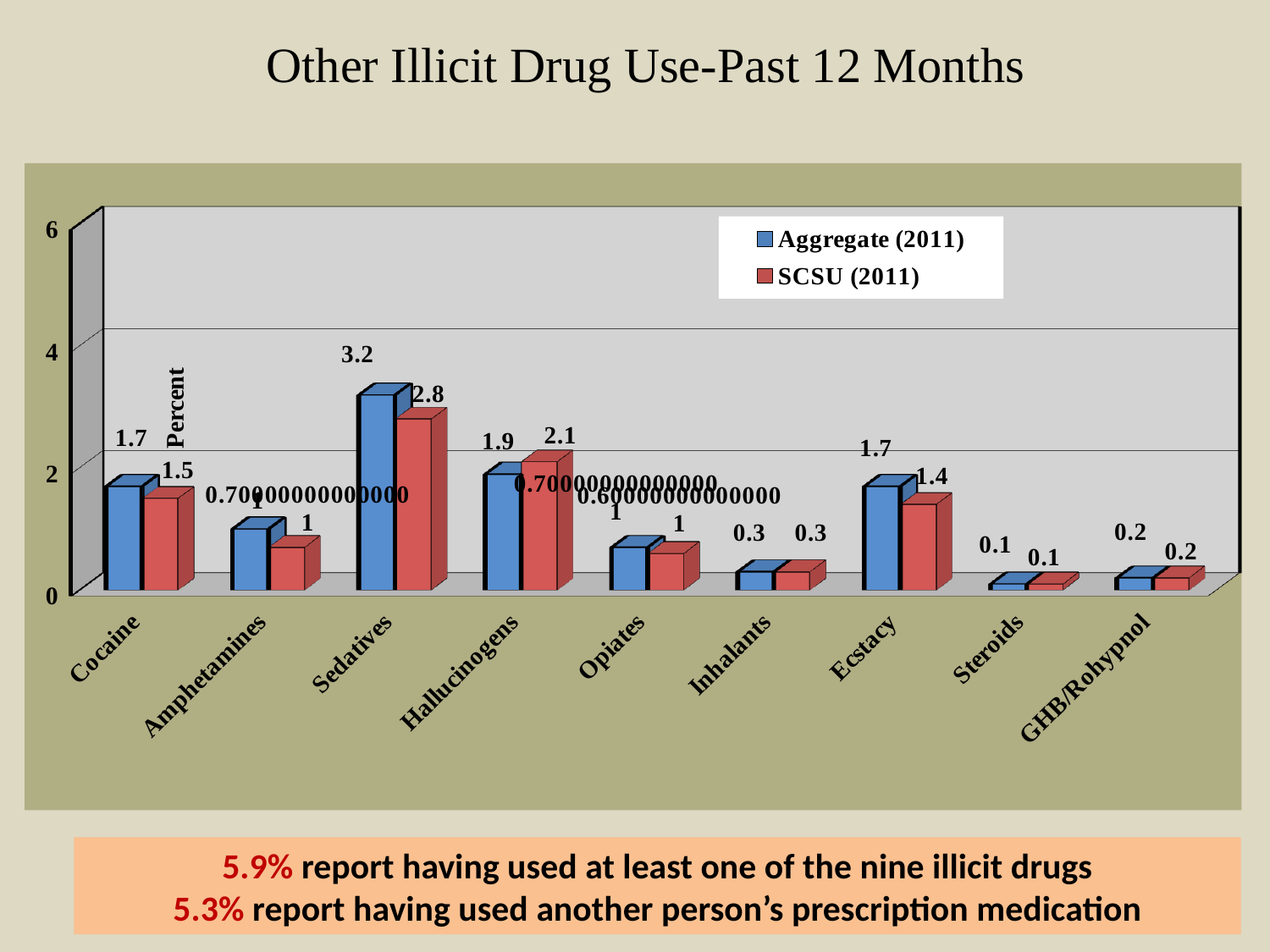
Which category has the lowest SCSU (2011) value? Steroids What is the Aggregate (2011) value for Sedatives? 3.2 For Hallucinogens, which series has the larger value, Aggregate (2011) or SCSU (2011)? SCSU (2011) What is the title of the chart? Other Illicit Drug Use-Past 12 Months Which category has the highest Aggregate (2011) value? Sedatives How many series does the legend list? 2 How many drug categories are shown on the x axis? 9 What is the difference between the Aggregate (2011) and SCSU (2011) values for Sedatives? 0.4 What is the Aggregate (2011) value for Cocaine? 1.7 What kind of chart is shown on the slide? bar chart What is the SCSU (2011) value for Hallucinogens? 2.1 What is the SCSU (2011) value for Sedatives? 2.8